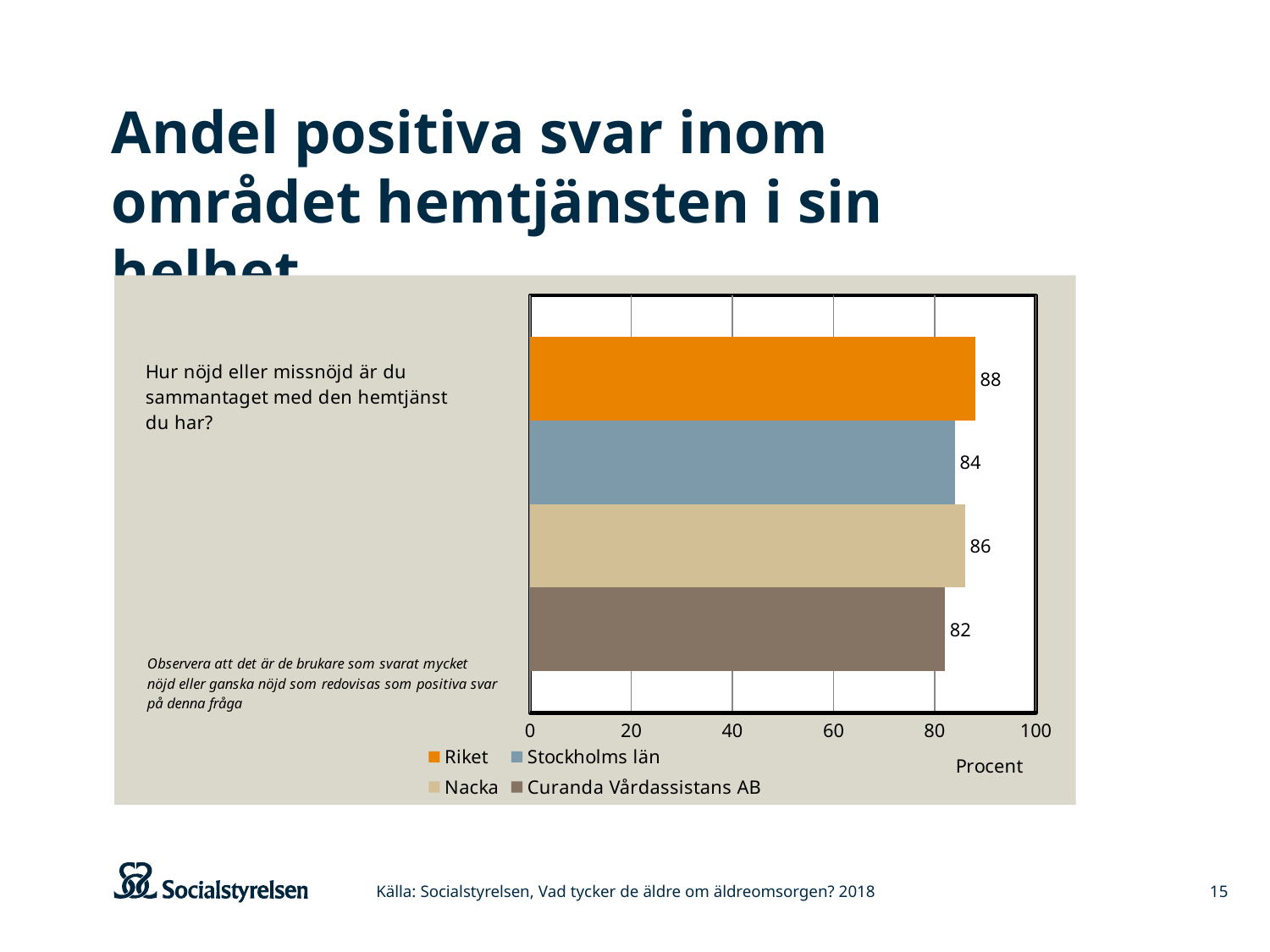
What is the value for Riket? 88 What kind of chart is shown on the slide? bar chart What is the value for Curanda Vårdassistans AB? 82 Which is larger, the value for Nacka or the value for Stockholms län? Nacka Which series has the lowest value? Curanda Vårdassistans AB What is the value for Nacka? 86 Which series has the highest value? Riket What is the value for Stockholms län? 84 What is the difference between the values for Riket and Curanda Vårdassistans AB? 6 Is the value for Curanda Vårdassistans AB greater or less than 80? greater What is the difference between the values for Nacka and Stockholms län? 2 How many series does the legend list? 4